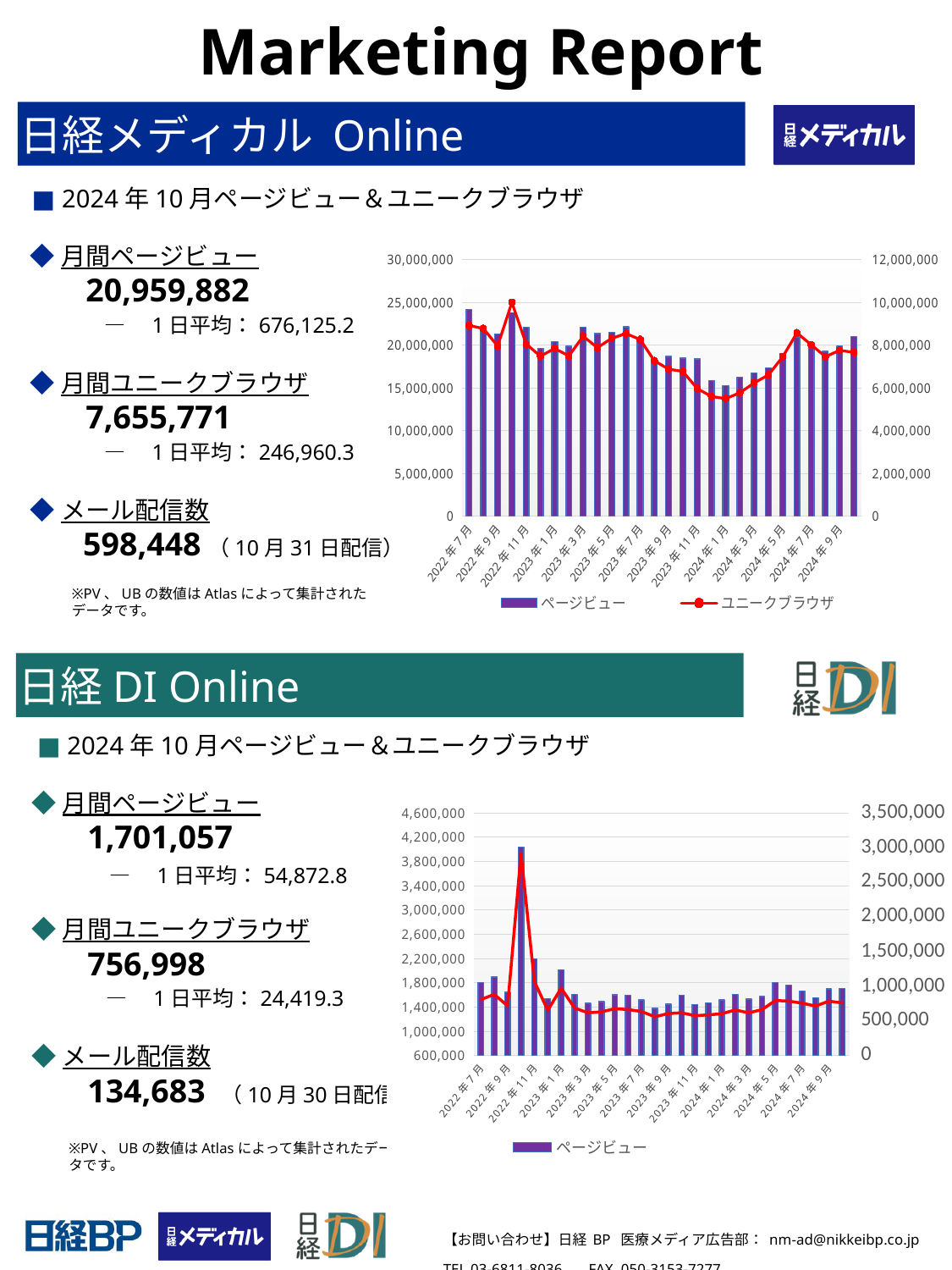
In the top chart (日経メディカル Online), do the ページビュー values rise or fall from 2023年7月 to 2024年1月? fall In the bottom chart (日経DI Online), how many series does the legend list? 1 In the top chart (日経メディカル Online), is the ユニークブラウザ value for 2024年1月 greater or less than 6,000,000? less In the top chart (日経メディカル Online), is the ページビュー value for 2022年7月 greater or less than 20,000,000? greater In the top chart (日経メディカル Online), which is larger, the ページビュー value for 2022年7月 or for 2024年1月? 2022年7月 What kind of chart is the top chart (日経メディカル Online)? bar and line chart In the bottom chart (日経DI Online), do the ページビュー values rise or fall from 2022年11月 to 2023年3月? fall In the top chart (日経メディカル Online), which month has the lowest ユニークブラウザ value? 2024年1月 In the bottom chart (日経DI Online), which month has the highest ページビュー value? 2022年10月 In the top chart (日経メディカル Online), how many series does the legend list? 2 In the top chart (日経メディカル Online), which month has the highest ユニークブラウザ value? 2022年10月 In the bottom chart (日経DI Online), is the ページビュー value for 2022年11月 greater or less than 3,800,000? less